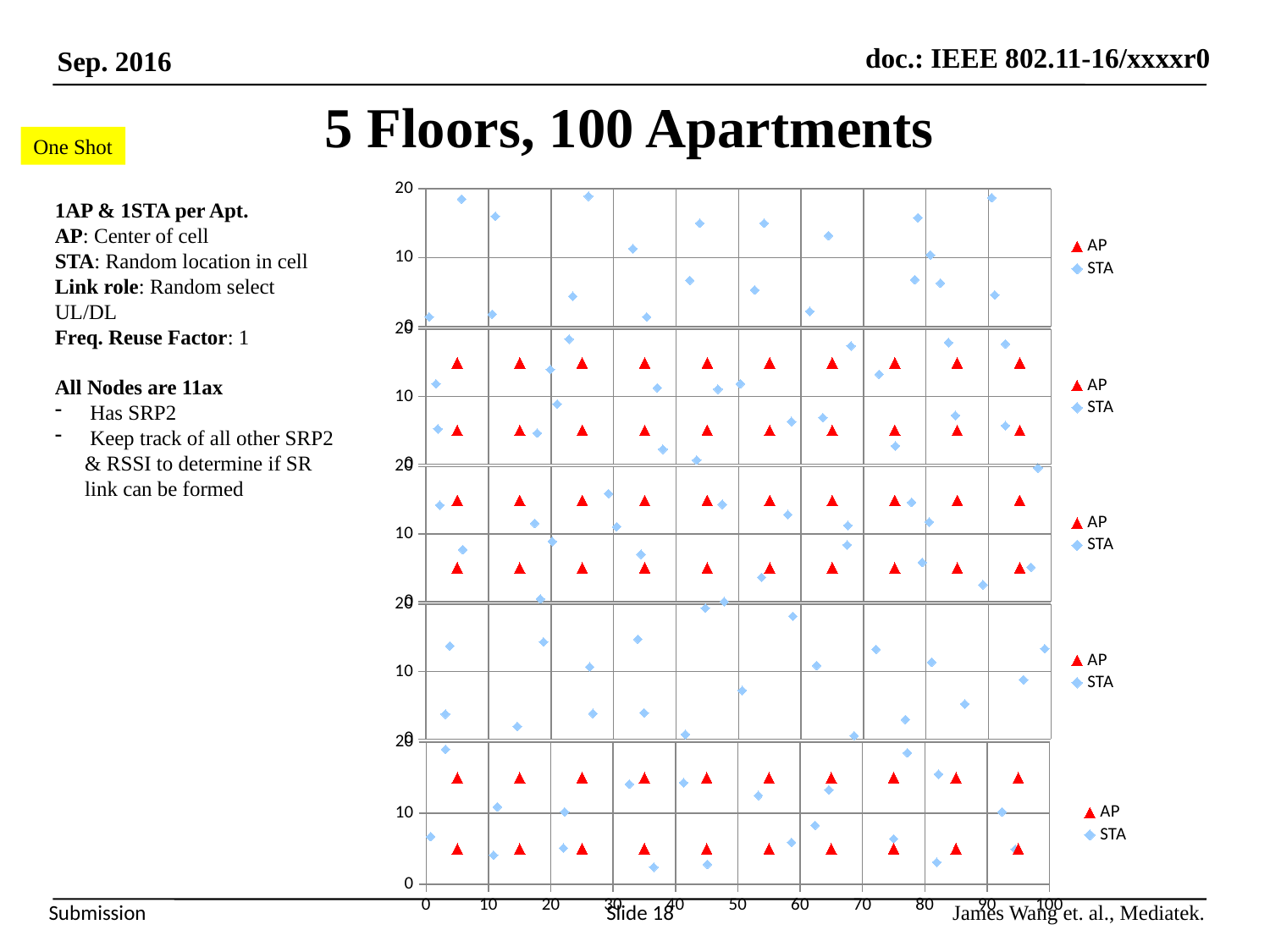
In the bottom chart, is the y value of the lower row of AP markers greater or less than 10? less In the bottom chart, is the y value of the upper row of AP markers greater or less than 10? greater In the second chart from the top, is the y value of the upper row of AP markers greater or less than 10? greater Which series is drawn with red triangle markers? AP How many series does the legend of the bottom chart list? 2 What are the two series named in the legend of the top chart? AP and STA What kind of chart is used on this slide? scatter chart